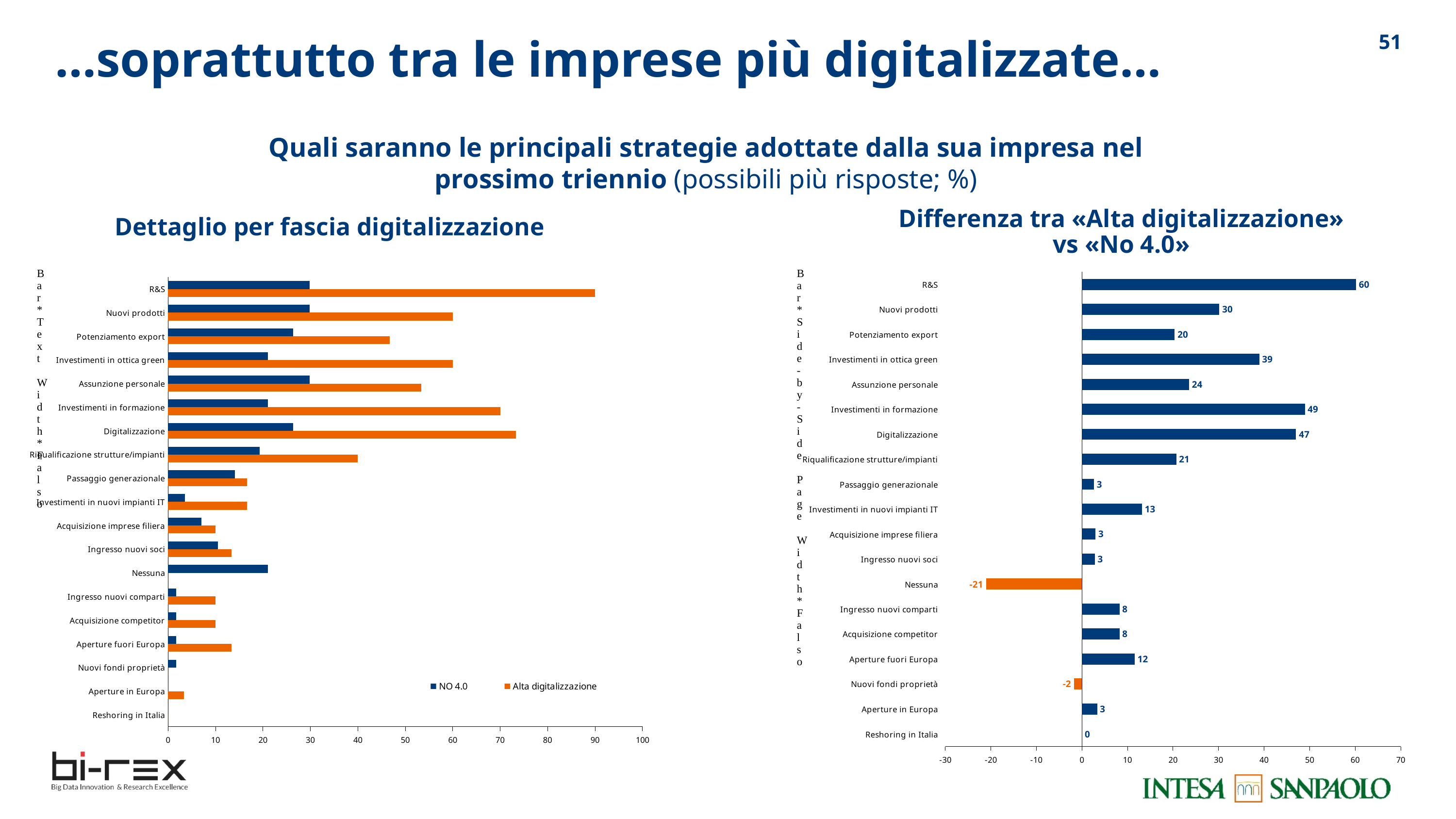
In the chart titled "Differenza tra «Alta digitalizzazione» vs «No 4.0»", what is the value for R&S? 60 In the chart titled "Differenza tra «Alta digitalizzazione» vs «No 4.0»", which category has the lowest value? Nessuna In the chart titled "Differenza tra «Alta digitalizzazione» vs «No 4.0»", how many categories are shown? 19 In the chart titled "Dettaglio per fascia digitalizzazione", how many series does the legend list? 2 In the chart titled "Dettaglio per fascia digitalizzazione", is the Alta digitalizzazione value for R&S greater or less than 80? greater In the chart titled "Differenza tra «Alta digitalizzazione» vs «No 4.0»", what is the value for Nessuna? -21 In the chart titled "Differenza tra «Alta digitalizzazione» vs «No 4.0»", which category has the highest value? R&S In the chart titled "Differenza tra «Alta digitalizzazione» vs «No 4.0»", what is the difference between the values for R&S and Nuovi prodotti? 30 In the chart titled "Dettaglio per fascia digitalizzazione", is the Alta digitalizzazione value for Potenziamento export greater or less than 50? less In the chart titled "Differenza tra «Alta digitalizzazione» vs «No 4.0»", which is larger: Digitalizzazione or Investimenti in ottica green? Digitalizzazione In the chart titled "Differenza tra «Alta digitalizzazione» vs «No 4.0»", what is the value for Investimenti in formazione? 49 What kind of chart is the chart titled "Dettaglio per fascia digitalizzazione"? Bar chart